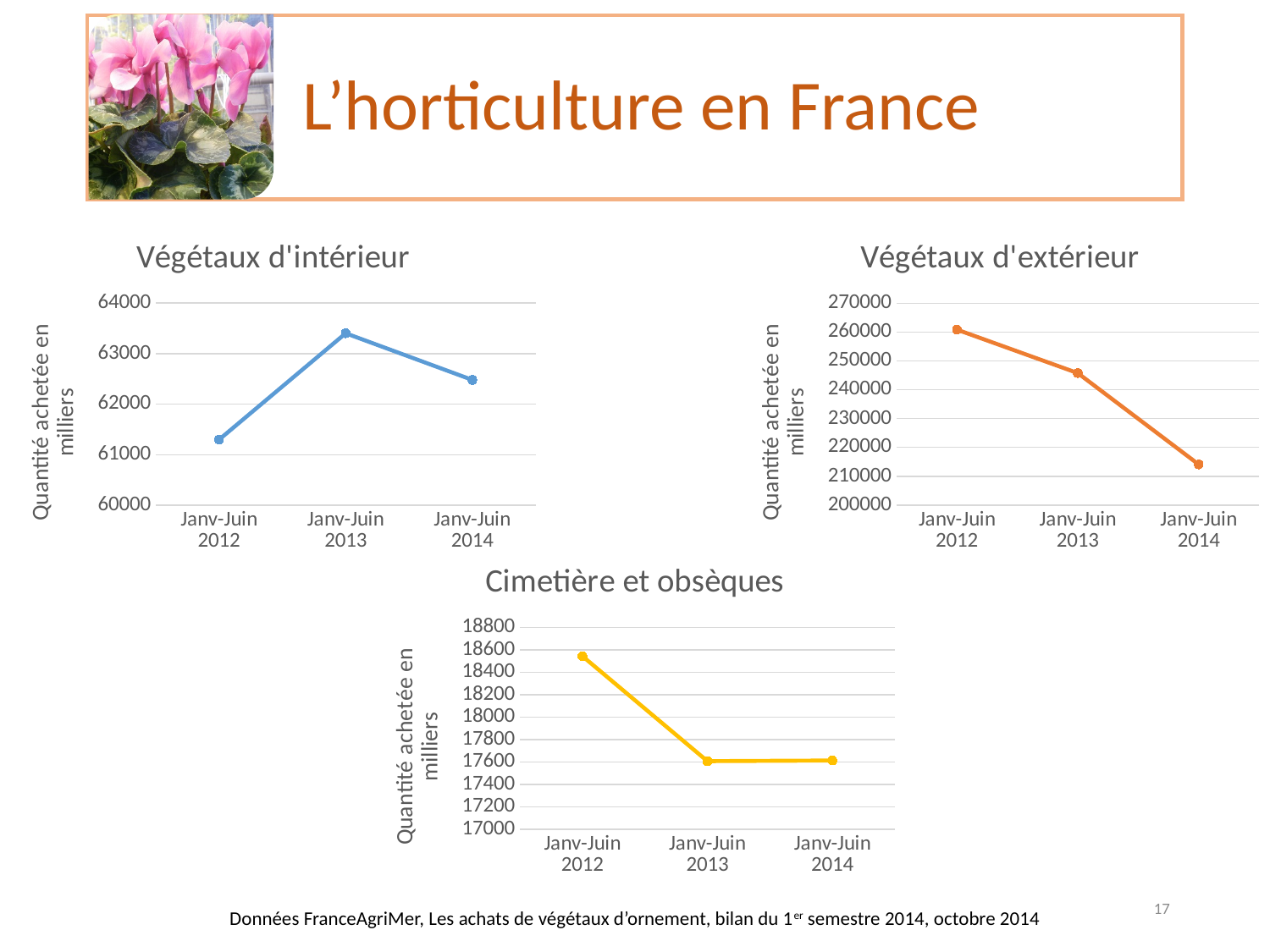
In the 'Végétaux d'extérieur' chart, which period has the lowest value? Janv-Juin 2014 In the 'Cimetière et obsèques' chart, is the value for Janv-Juin 2013 greater or less than 18000? less In the 'Végétaux d'extérieur' chart, is the value for Janv-Juin 2013 greater or less than 250000? less In the 'Cimetière et obsèques' chart, which period has the highest value? Janv-Juin 2012 In the 'Végétaux d'extérieur' chart, do the values rise or fall from Janv-Juin 2012 to Janv-Juin 2014? fall In the 'Végétaux d'intérieur' chart, is the value for Janv-Juin 2013 greater or less than 63000? greater In the 'Végétaux d'intérieur' chart, which period has the highest value? Janv-Juin 2013 In the 'Cimetière et obsèques' chart, which is larger, the value for Janv-Juin 2012 or Janv-Juin 2014? Janv-Juin 2012 What kind of chart is 'Cimetière et obsèques'? line chart How many data points are plotted in the 'Végétaux d'intérieur' chart? 3 In the 'Végétaux d'intérieur' chart, which period has the lowest value? Janv-Juin 2012